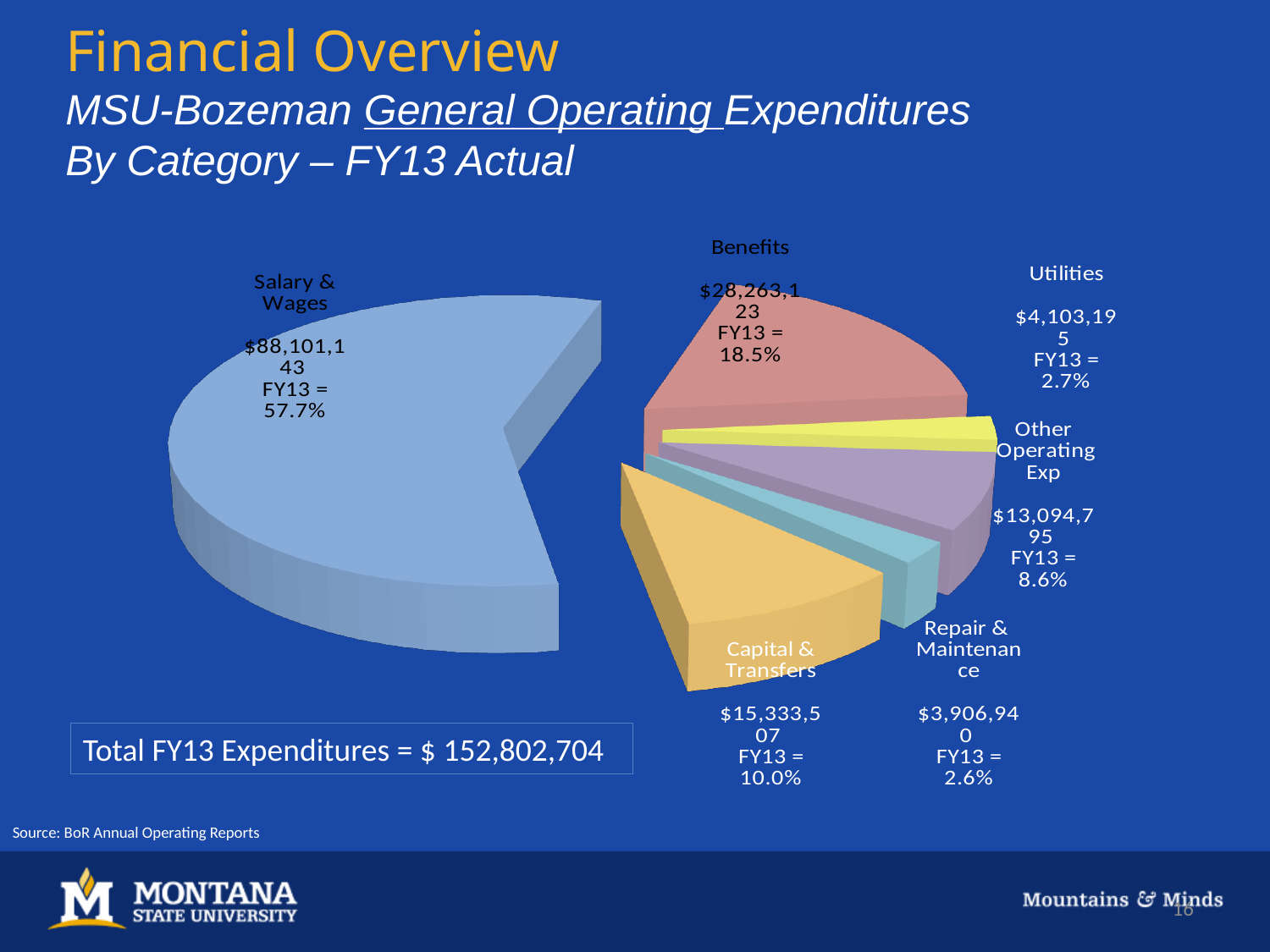
Which category has the largest share of FY13 expenditures? Salary & Wages Which is larger, Benefits or Capital & Transfers? Benefits What is the difference in percentage share between Utilities and Repair & Maintenance? 0.1% What is the FY13 value for Capital & Transfers? $15,333,507 What is the total FY13 expenditure shown on the slide? $ 152,802,704 Which category has the smallest share of FY13 expenditures? Repair & Maintenance What is the source cited for the chart data? BoR Annual Operating Reports What share of FY13 expenditures is Benefits? 18.5% How many categories does the pie chart show? 6 What kind of chart is shown on the slide? pie chart What is the FY13 value for Salary & Wages? $88,101,143 What share of FY13 expenditures is Other Operating Exp? 8.6%